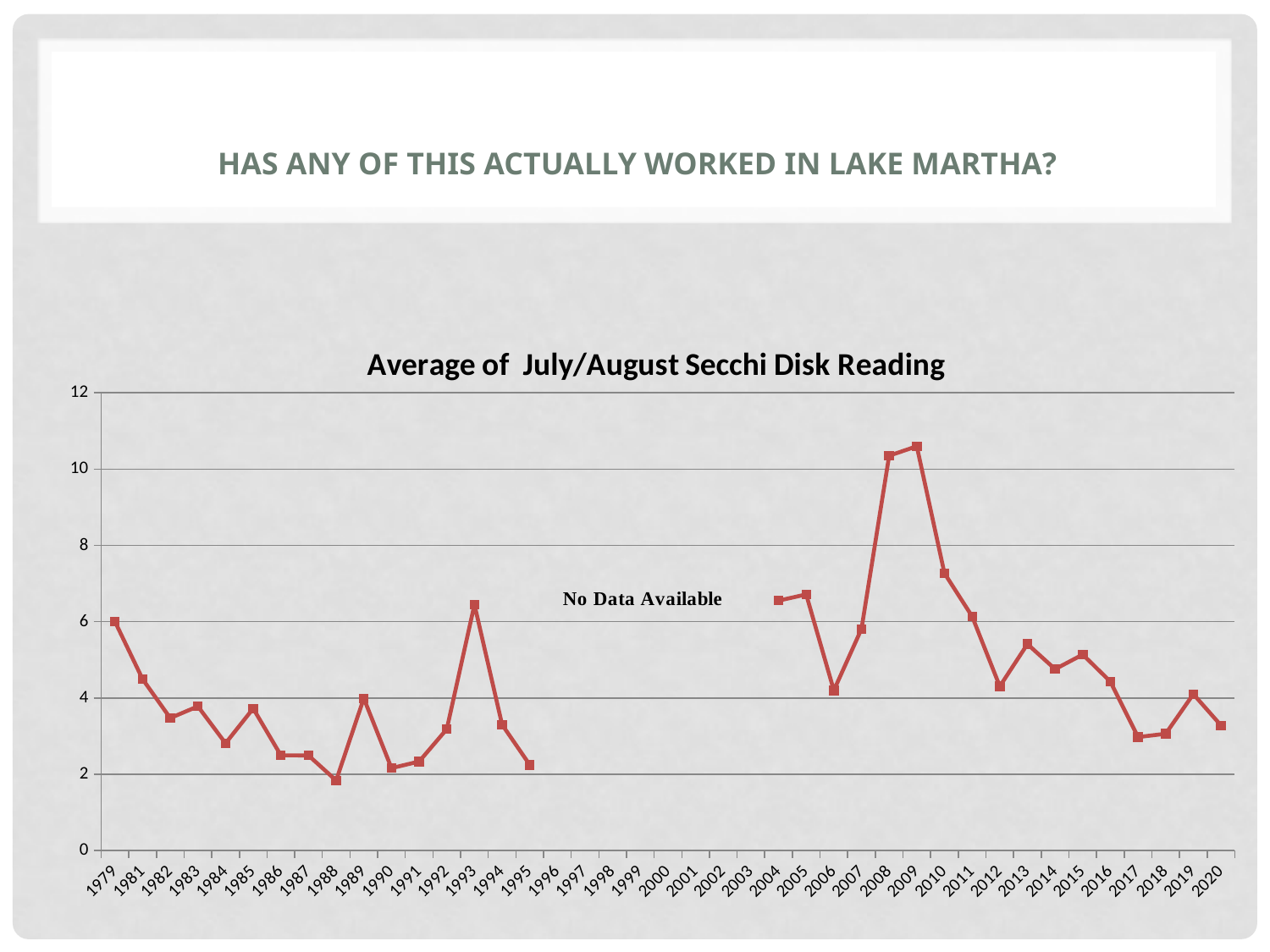
Is the value for 2017 greater or less than 4? less What is the title of the chart? Average of July/August Secchi Disk Reading Is the value for 2009 greater or less than 10? greater Which year has the larger Secchi disk reading, 1993 or 2009? 2009 Is the value for 1988 greater or less than 2? less What is the Secchi disk reading for 1979? 6 What kind of chart is shown on the slide? line chart Which year has the highest Secchi disk reading? 2009 Do the values rise or fall from 2009 to 2012? fall What text is written in the gap between 1995 and 2004 on the chart? No Data Available Which year has the lowest Secchi disk reading? 1988